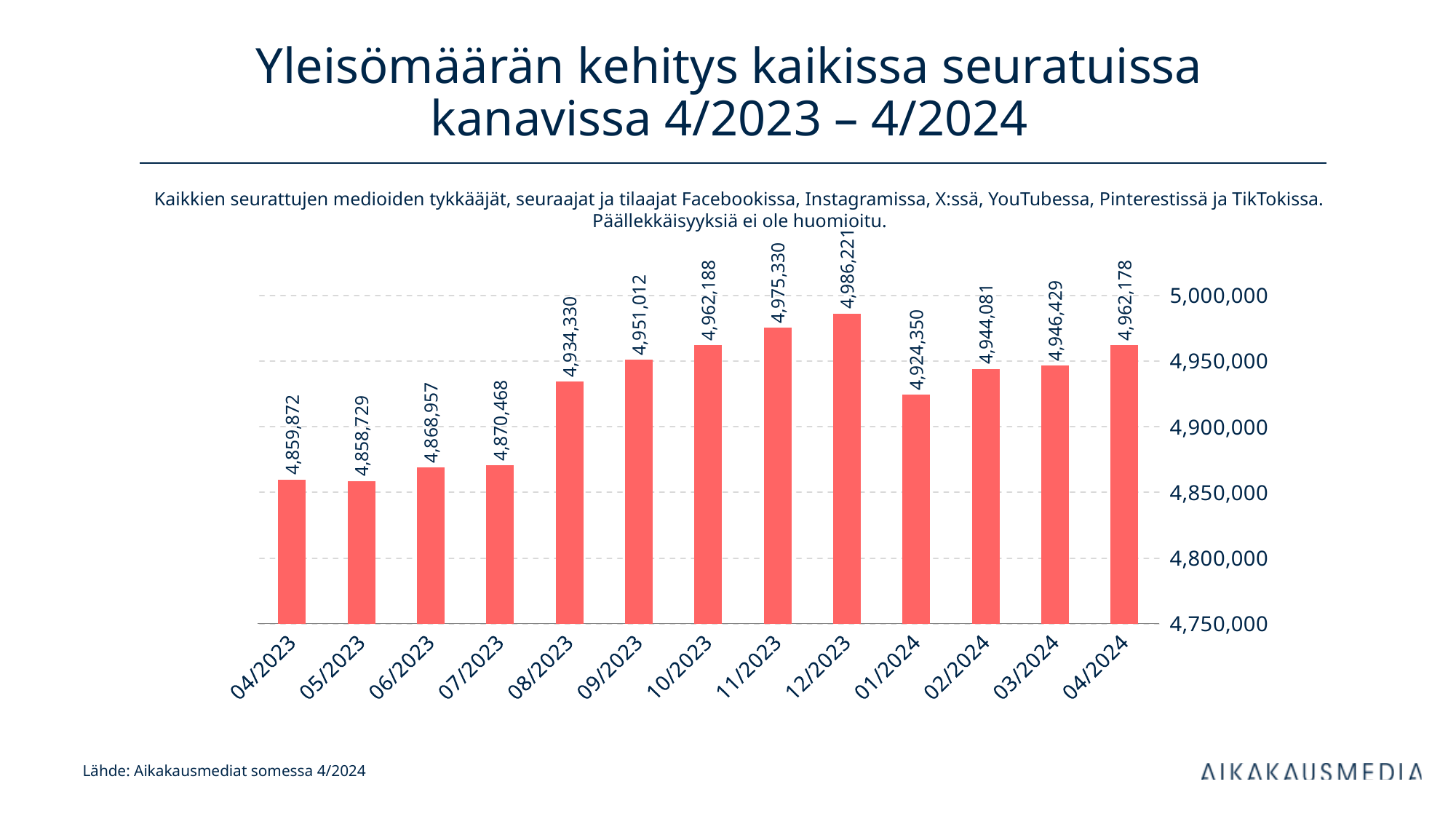
Which month has the highest value? 12/2023 Is the value for 07/2023 greater or less than 4,900,000? less What is the value for 01/2024? 4,924,350 Which month has the lowest value? 05/2023 Which is larger, the value for 08/2023 or the value for 02/2024? 02/2024 What kind of chart is shown on the slide? bar chart How many months are shown on the x axis? 13 What is the value for 12/2023? 4,986,221 What is the value for 04/2023? 4,859,872 Do the values rise or fall from 04/2023 to 12/2023? rise What is the difference between the values for 12/2023 and 01/2024? 61,871 What is the difference between the values for 04/2024 and 04/2023? 102,306